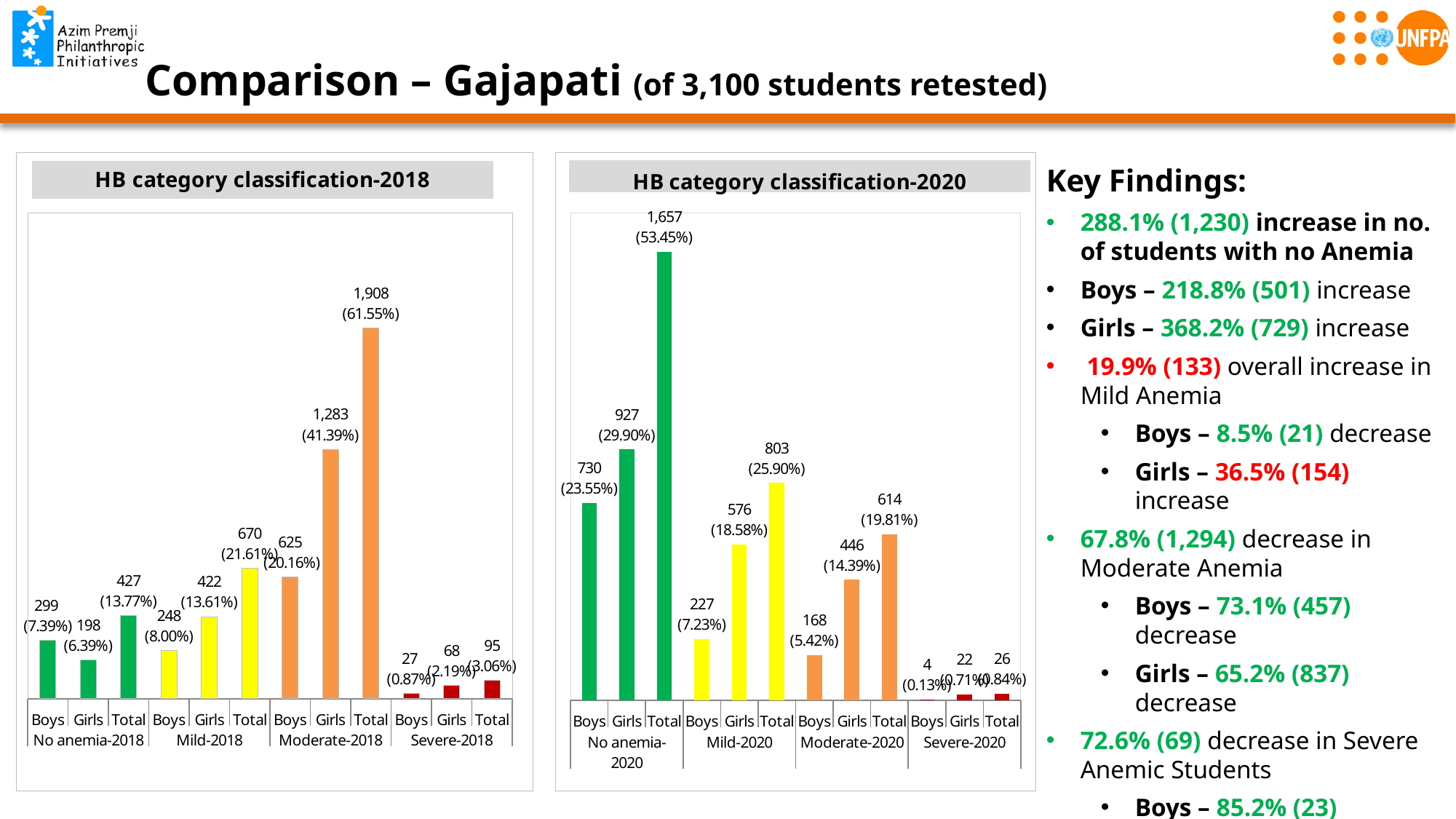
In the HB category classification-2020 chart, what is the value for Boys in Severe-2020? 4 In the HB category classification-2020 chart, what is the value for Total in No anemia-2020? 1,657 In the HB category classification-2018 chart, what is the value for Girls in Moderate-2018? 1,283 In the HB category classification-2018 chart, what percentage is shown for Boys in Mild-2018? 8.00% In the HB category classification-2020 chart, which is larger: Girls in No anemia-2020 or Total in Mild-2020? Girls in No anemia-2020 In the HB category classification-2018 chart, what is the difference between the Total values for Moderate-2018 and Mild-2018? 1,238 What type of chart is the HB category classification-2020 chart? Bar chart In the HB category classification-2020 chart, what is the difference between the Girls and Boys values in Mild-2020? 349 In the HB category classification-2020 chart, what colour are the Moderate-2020 bars? Orange How many bars are plotted in the HB category classification-2018 chart? 12 In the HB category classification-2018 chart, which bar has the highest value? Total, Moderate-2018 In the HB category classification-2020 chart, which bar has the lowest value? Boys, Severe-2020